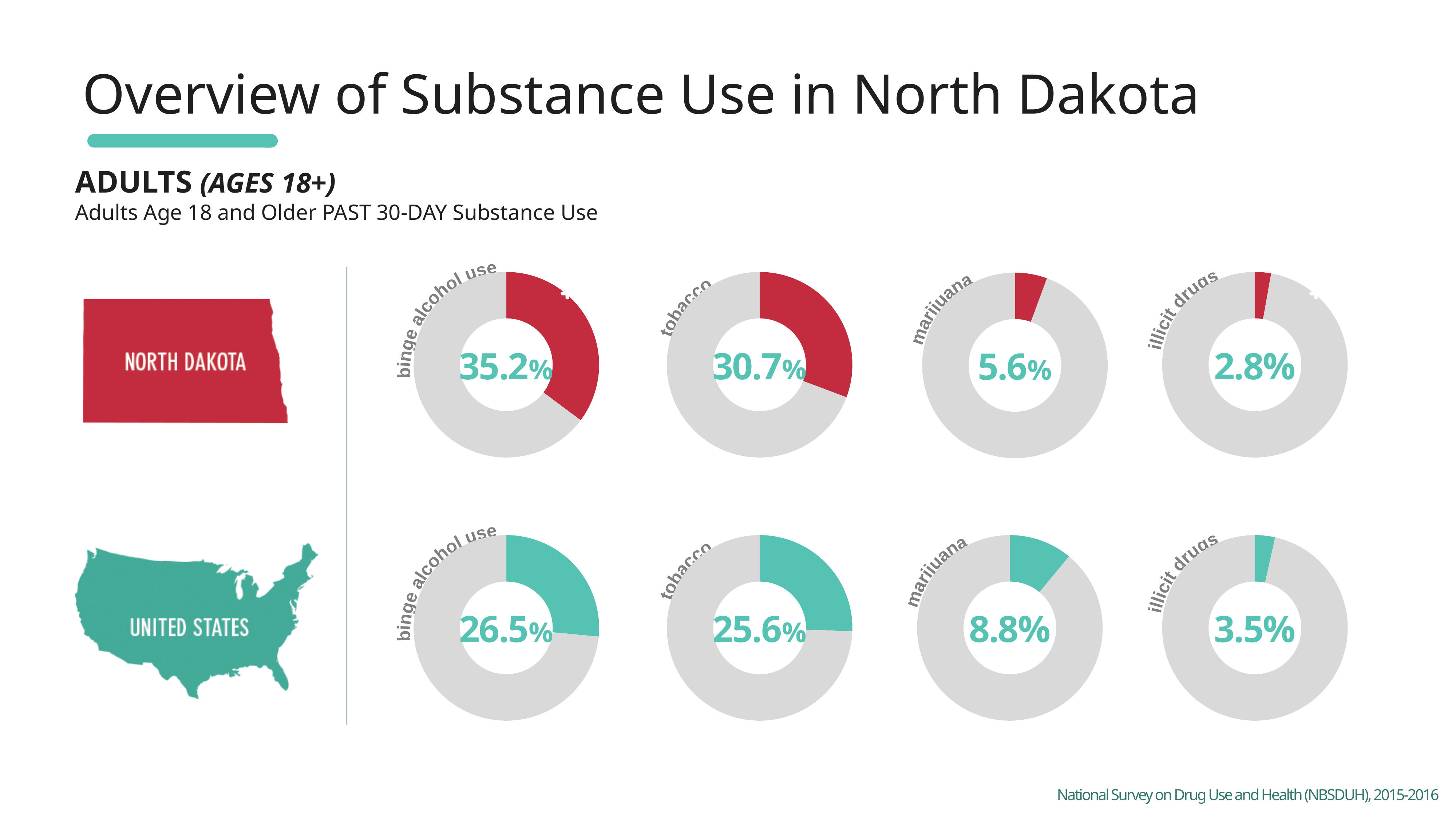
What is the North Dakota past 30-day binge alcohol use rate for adults shown on the slide? 35.2% What is the United States past 30-day illicit drugs use rate for adults? 3.5% What colour are the filled segments of the United States donut charts? Teal What is the difference between the United States and North Dakota marijuana use rates? 3.2 percentage points How many donut charts are shown for North Dakota on the slide? 4 What is the North Dakota past 30-day marijuana use rate for adults? 5.6% How much higher is the North Dakota binge alcohol use rate than the United States binge alcohol use rate? 8.7 percentage points Which is larger: the North Dakota illicit drugs rate or the United States illicit drugs rate? United States Which is larger: the North Dakota tobacco use rate or the United States tobacco use rate? North Dakota What is the United States past 30-day tobacco use rate for adults shown on the slide? 25.6% Among the United States donut charts, which substance has the lowest past 30-day use rate? illicit drugs Among the North Dakota donut charts, which substance has the highest past 30-day use rate? binge alcohol use